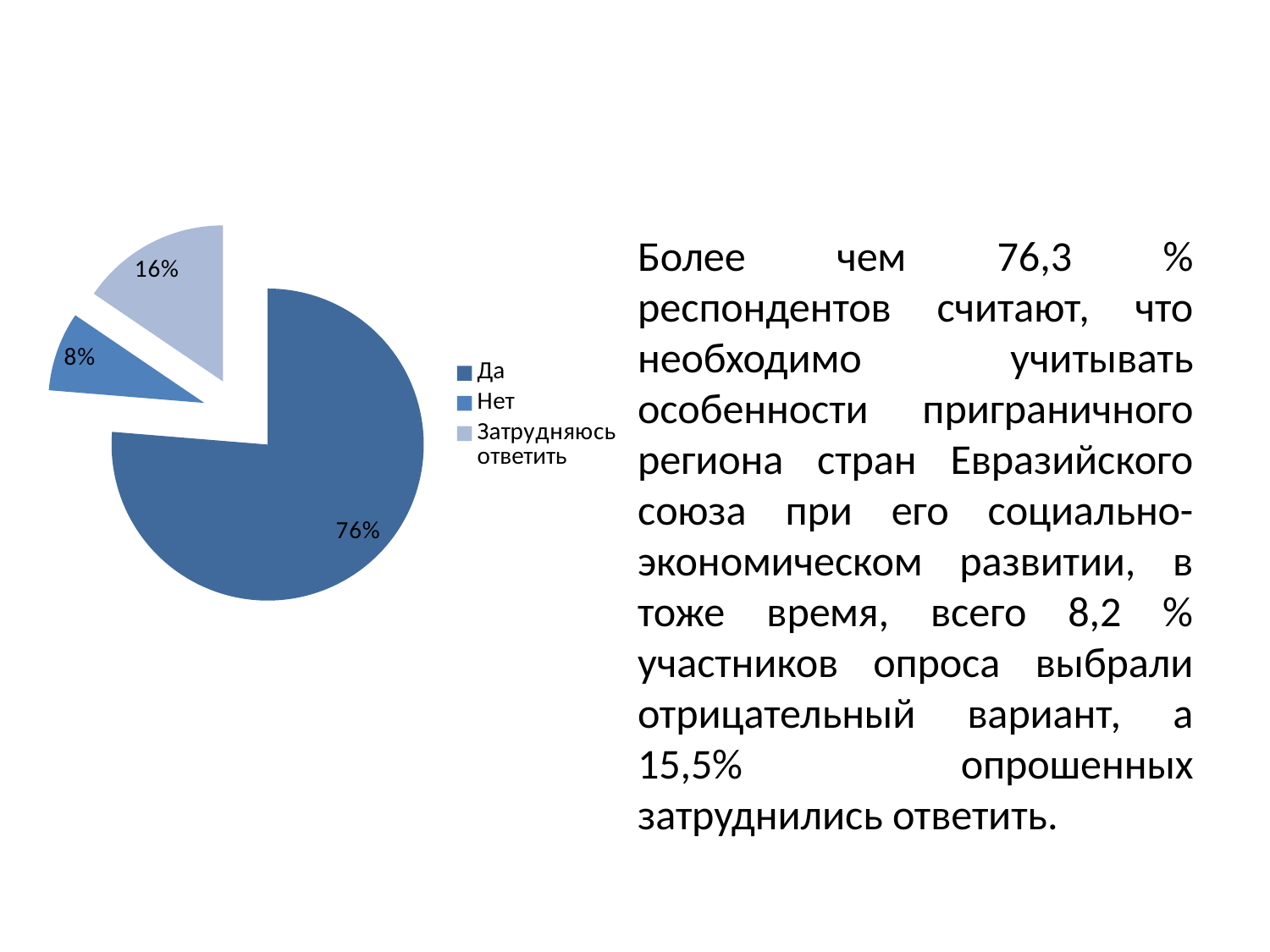
What kind of chart is shown on the slide? pie chart What is the difference in percentage points between the "Да" slice and the "Затрудняюсь ответить" slice? 60 How many slices does the pie chart have? 3 Which slice is larger, "Нет" or "Затрудняюсь ответить"? Затрудняюсь ответить What share of the pie does the "Затрудняюсь ответить" slice represent? 16% Which legend entry is shown in the lightest shade of blue? Затрудняюсь ответить Which category has the smallest slice of the pie? Нет What share of the pie does the "Нет" slice represent? 8% How many entries does the legend list? 3 Which category has the largest slice of the pie? Да What is the difference in percentage points between the "Затрудняюсь ответить" slice and the "Нет" slice? 8 What share of the pie does the "Да" slice represent? 76%